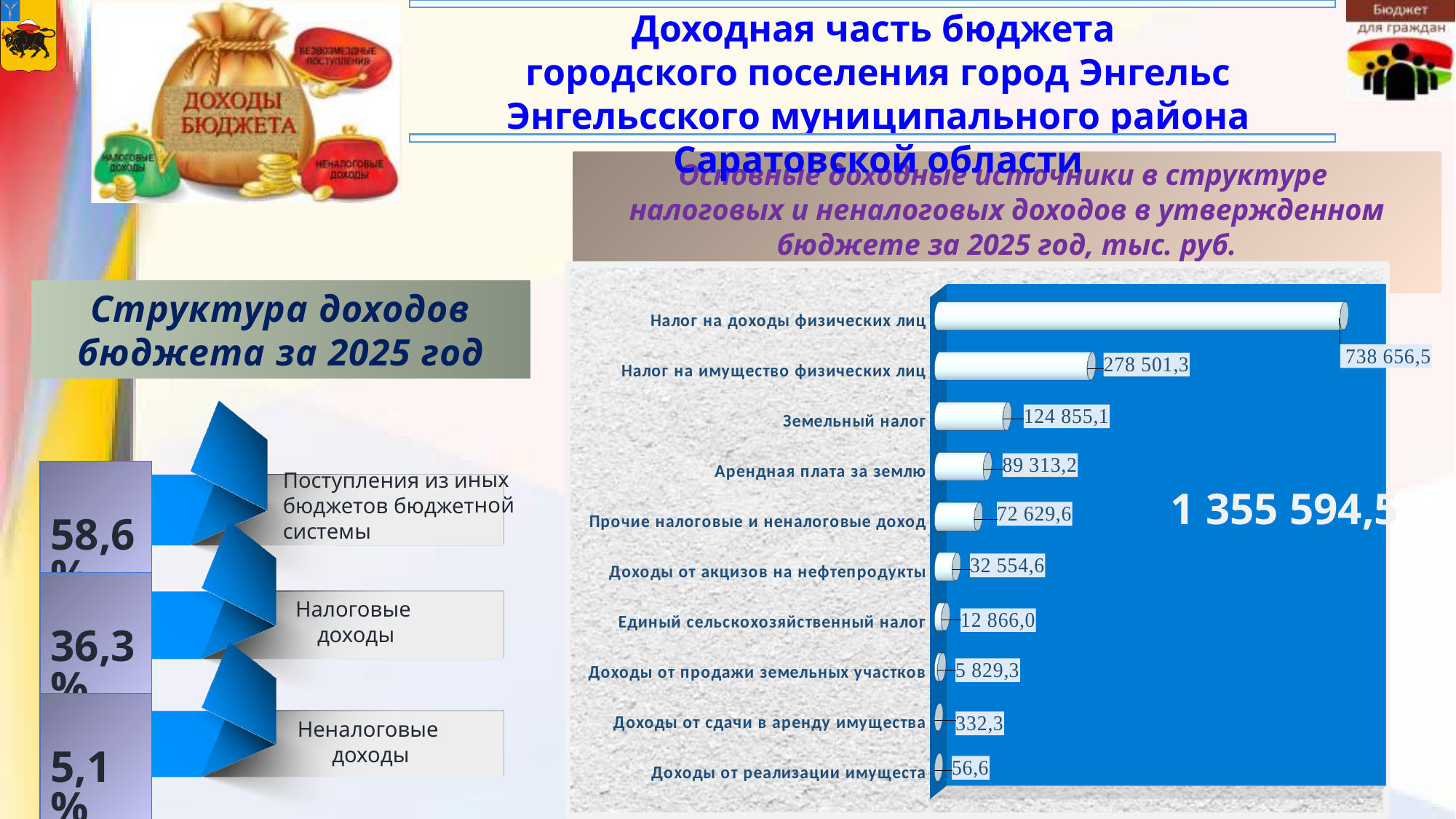
What is the difference between Налог на доходы физических лиц and Налог на имущество физических лиц in the bar chart? 460 155,2 Which category has the lowest value in the bar chart? Доходы от реализации имущеста Which category has the highest value in the bar chart? Налог на доходы физических лиц What is the value for Налог на доходы физических лиц in the bar chart? 738 656,5 Which is larger in the bar chart: Единый сельскохозяйственный налог or Доходы от продажи земельных участков? Единый сельскохозяйственный налог What is the value for Доходы от сдачи в аренду имущества in the bar chart? 332,3 What is the value for Доходы от акцизов на нефтепродукты in the bar chart? 32 554,6 What type of chart is shown on the right side of the slide? bar chart What is the value for Земельный налог in the bar chart? 124 855,1 What total figure is printed inside the bar chart area? 1 355 594,5 How many categories are plotted in the bar chart? 10 What is the difference between Земельный налог and Арендная плата за землю in the bar chart? 35 541,9